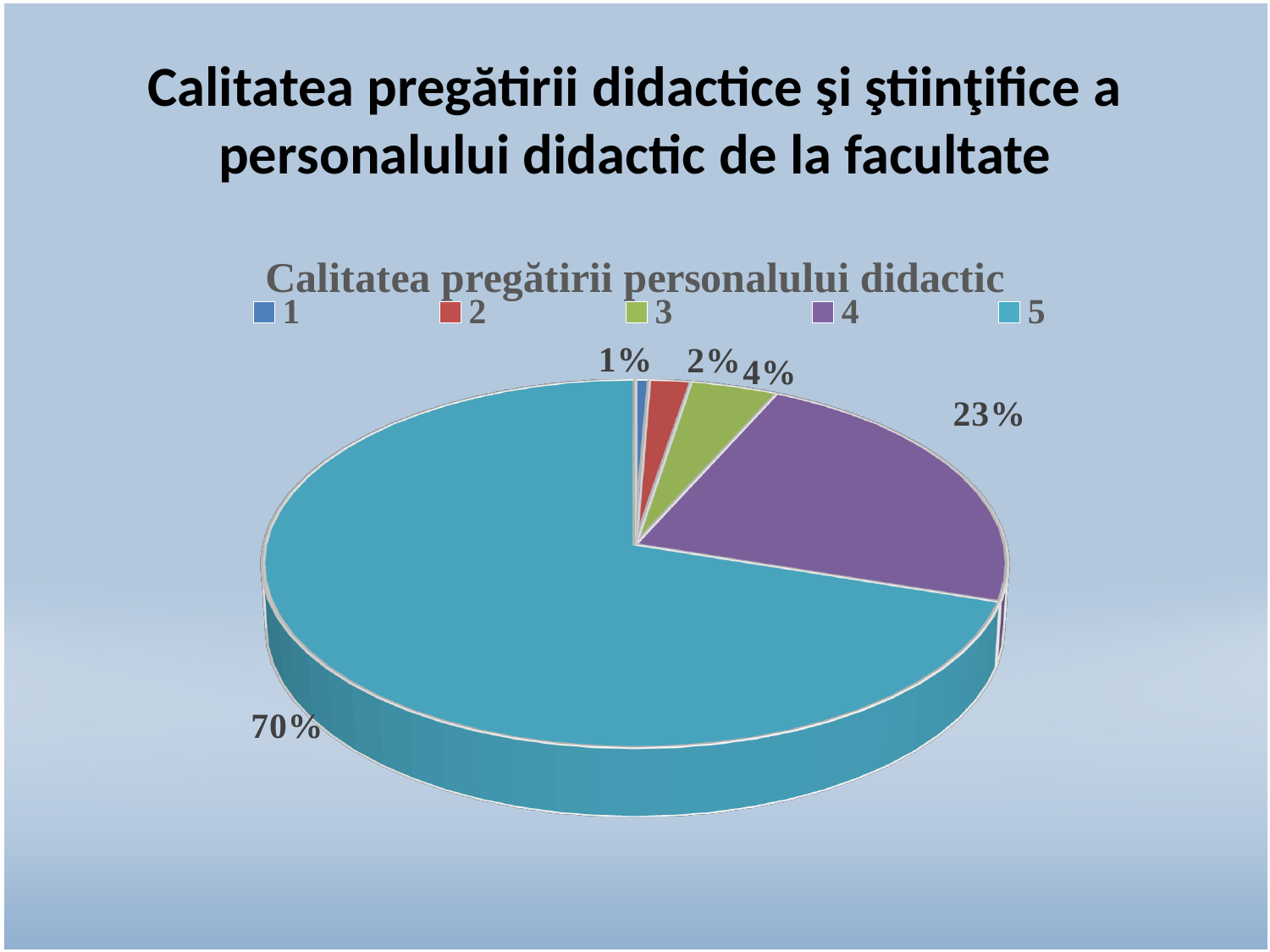
What is the value for category 2? 2% What is the value for category 3? 4% Which category has the largest slice? 5 What is the difference between the shares of category 5 and category 4? 47% What is the chart's title? Calitatea pregătirii personalului didactic What share of the pie does category 4 have? 23% What share of the pie does category 5 have? 70% What is the value for category 1? 1% Which category has the smallest slice? 1 How many categories does the legend list? 5 Which is larger, the slice for category 3 or the slice for category 2? 3 What kind of chart is shown on the slide? Pie chart